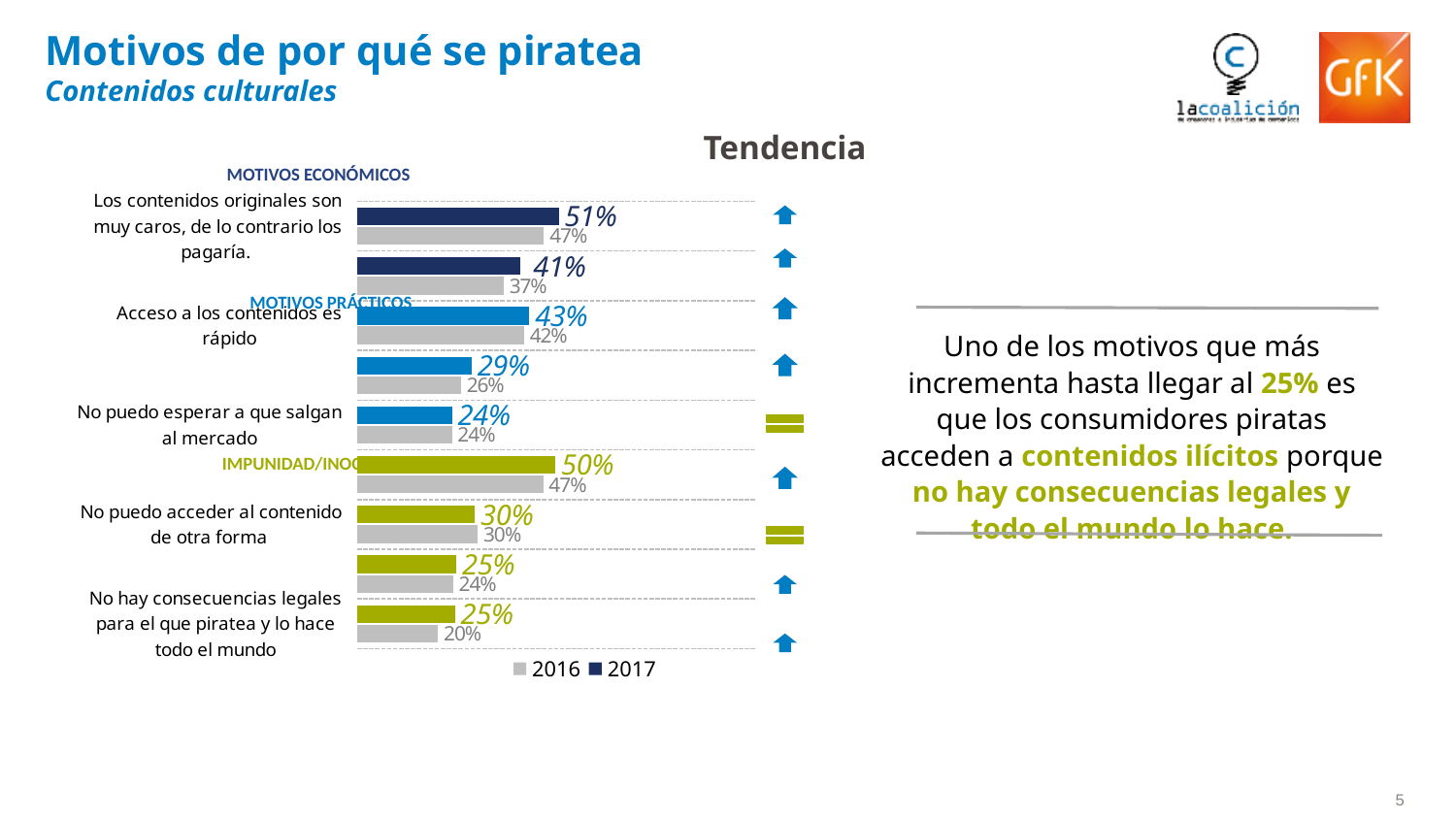
What kind of chart is shown on the slide? Bar chart What is the heading above the arrow column to the right of the bars? Tendencia What is the 2017 value for "Los contenidos originales son muy caros, de lo contrario los pagaría"? 51% What are the two entries in the chart legend? 2016 and 2017 What is the 2017 value for "No hay consecuencias legales para el que piratea y lo hace todo el mundo"? 25% For "Los contenidos originales son muy caros", which year has the larger value, 2016 or 2017? 2017 How many pairs of bars are plotted in the chart? 9 What is the highest 2017 value shown in the chart? 51% What is the 2016 value for "Los contenidos originales son muy caros, de lo contrario los pagaría"? 47% What is the lowest 2016 value shown in the chart? 20% How many series does the legend list? 2 By how many percentage points did "Los contenidos originales son muy caros" change from 2016 to 2017? 4 percentage points